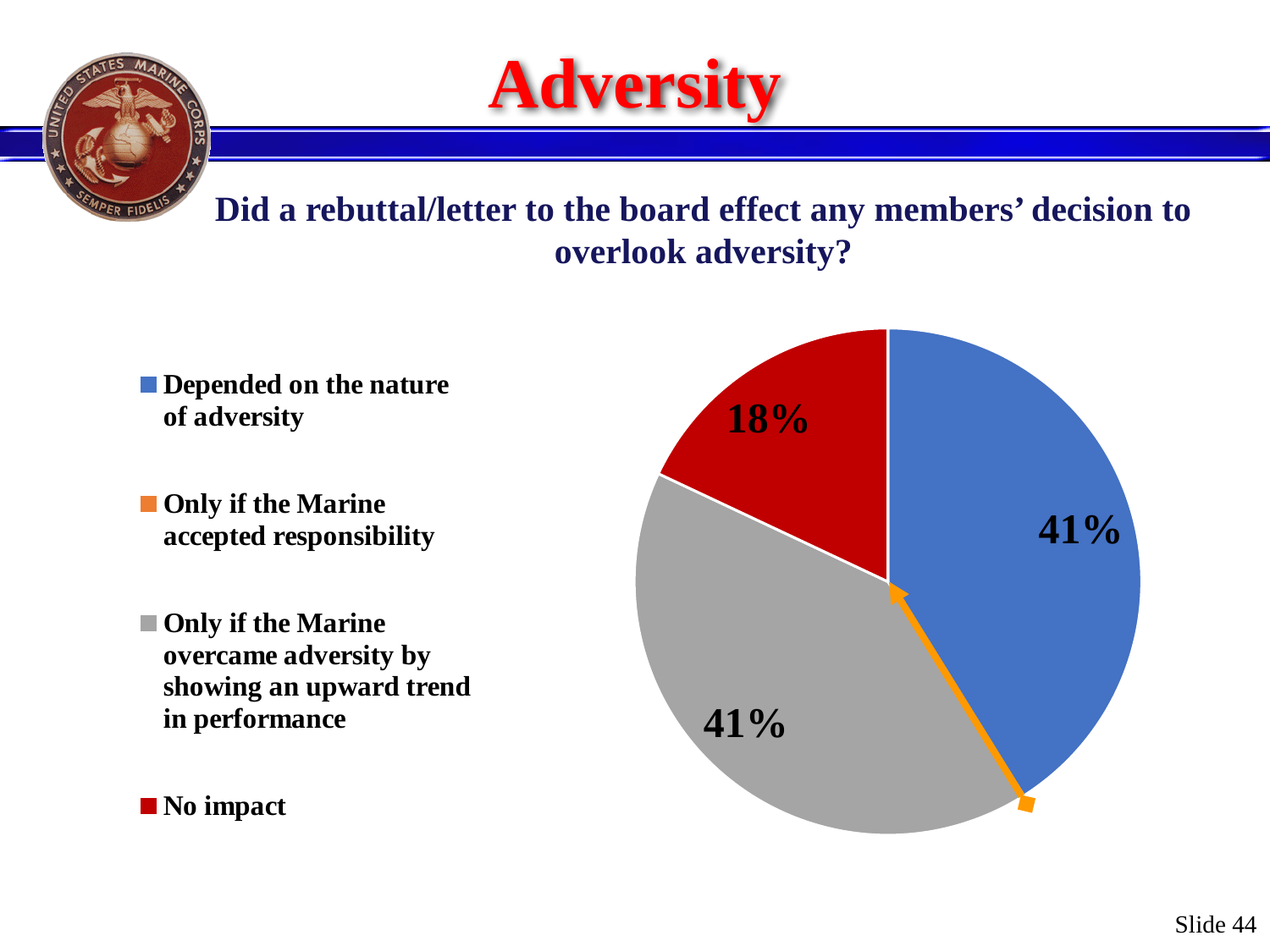
How many categories are shown in the legend of the pie chart? 4 What share of the pie is labelled for 'Only if the Marine overcame adversity by showing an upward trend in performance'? 41% What share of the pie is labelled for 'Depended on the nature of adversity'? 41% What colour is the slice for 'No impact'? red What share of the pie is labelled for 'No impact'? 18% What kind of chart is shown on the slide? pie chart How many entries does the legend list? 4 Which category has the smallest slice of the pie? Only if the Marine accepted responsibility What is the difference between the 'Depended on the nature of adversity' share and the 'No impact' share? 23% What question does the chart on the slide answer? Did a rebuttal/letter to the board effect any members' decision to overlook adversity? What is the combined share of the two slices labelled 41%? 82% Which is larger: the slice for 'No impact' or the slice for 'Depended on the nature of adversity'? Depended on the nature of adversity